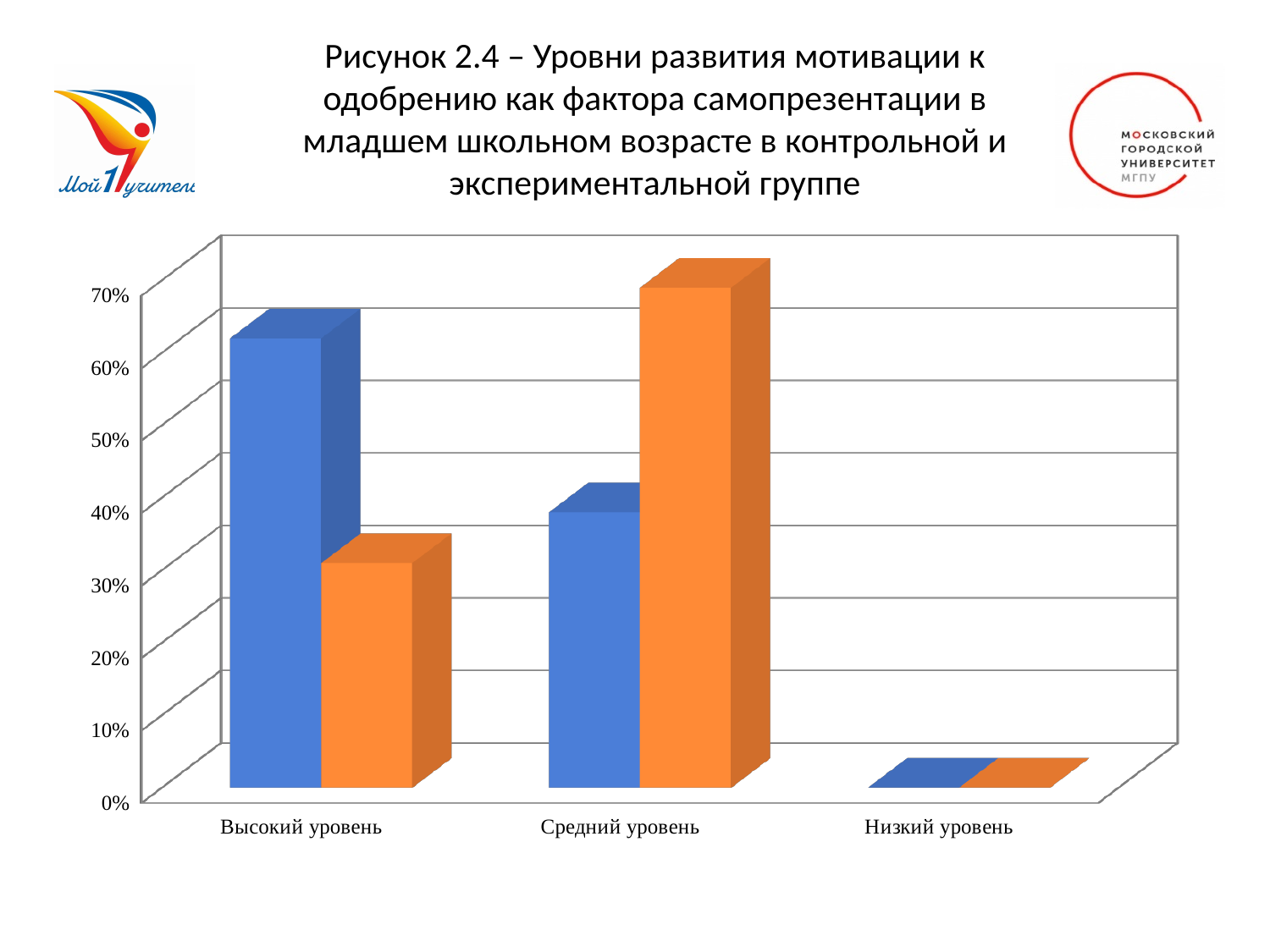
Is the value of the blue bar for Высокий уровень greater or less than 50%? greater Which category has the highest orange bar? Средний уровень What is the figure number given in the chart title? Рисунок 2.4 For Высокий уровень, which bar is taller, the blue one or the orange one? blue What kind of chart is shown on the slide? bar chart Is the value of the orange bar for Высокий уровень greater or less than 40%? less How many categories are shown on the x axis of the chart? 3 For Средний уровень, which bar is taller, the blue one or the orange one? orange Which category has the lowest bars for both series? Низкий уровень Is the value of the orange bar for Средний уровень greater or less than 60%? greater Which category has the highest blue bar? Высокий уровень